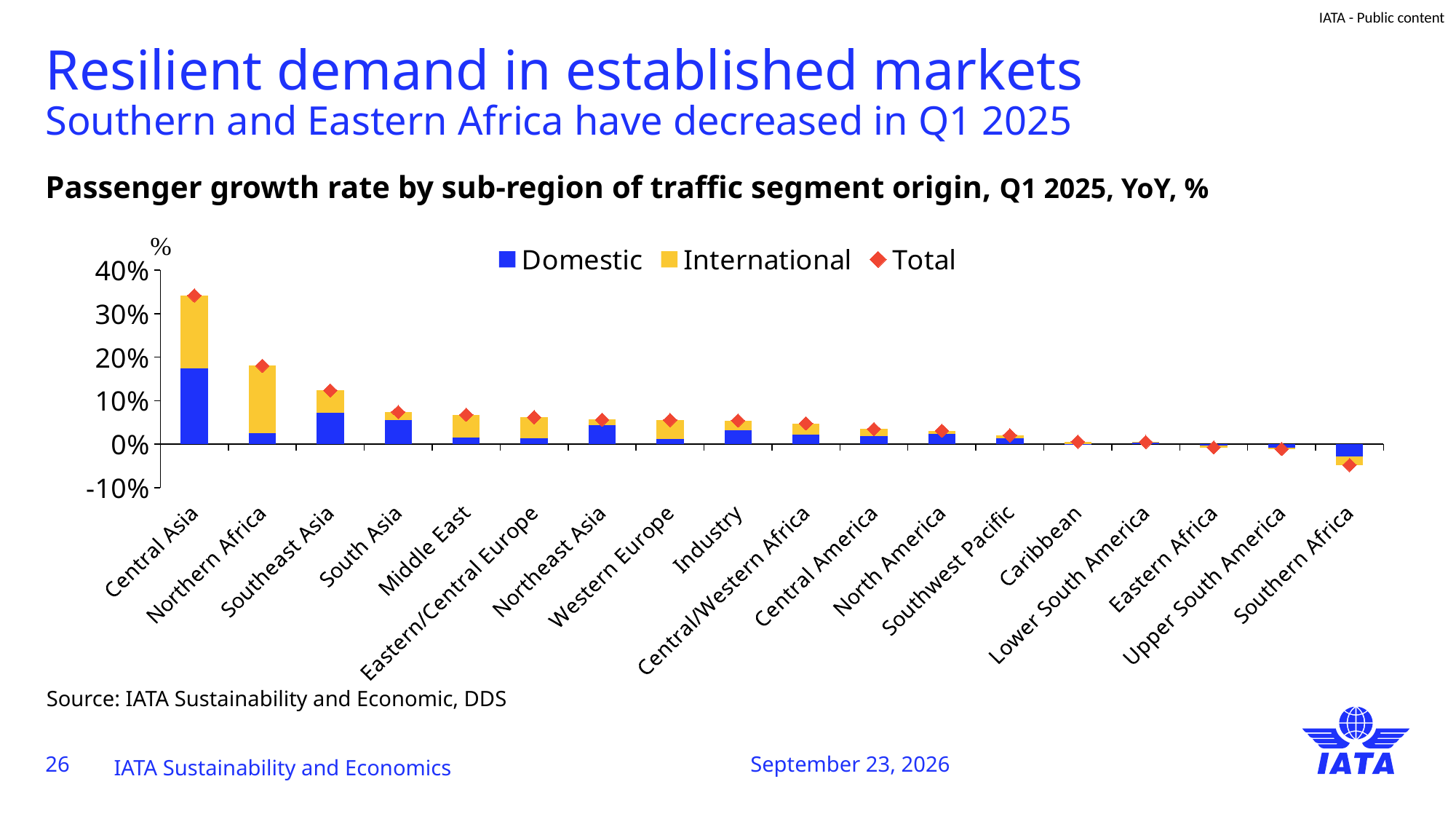
Is the total growth rate for Southeast Asia greater or less than 10%? greater How many sub-regions are shown along the x axis of the chart? 18 Is the Domestic growth rate for Central Asia greater or less than 10%? greater Is the total growth rate for Central Asia greater or less than 30%? greater Which has the larger total growth rate, Central Asia or Northern Africa? Central Asia Do the total growth rates generally rise or fall moving from left to right along the x axis? fall Which colour represents the International series in the chart? yellow Which sub-region has the highest total passenger growth rate? Central Asia Which sub-region has the lowest total passenger growth rate? Southern Africa How many series does the chart legend list? 3 What kind of chart is shown on the slide? bar chart